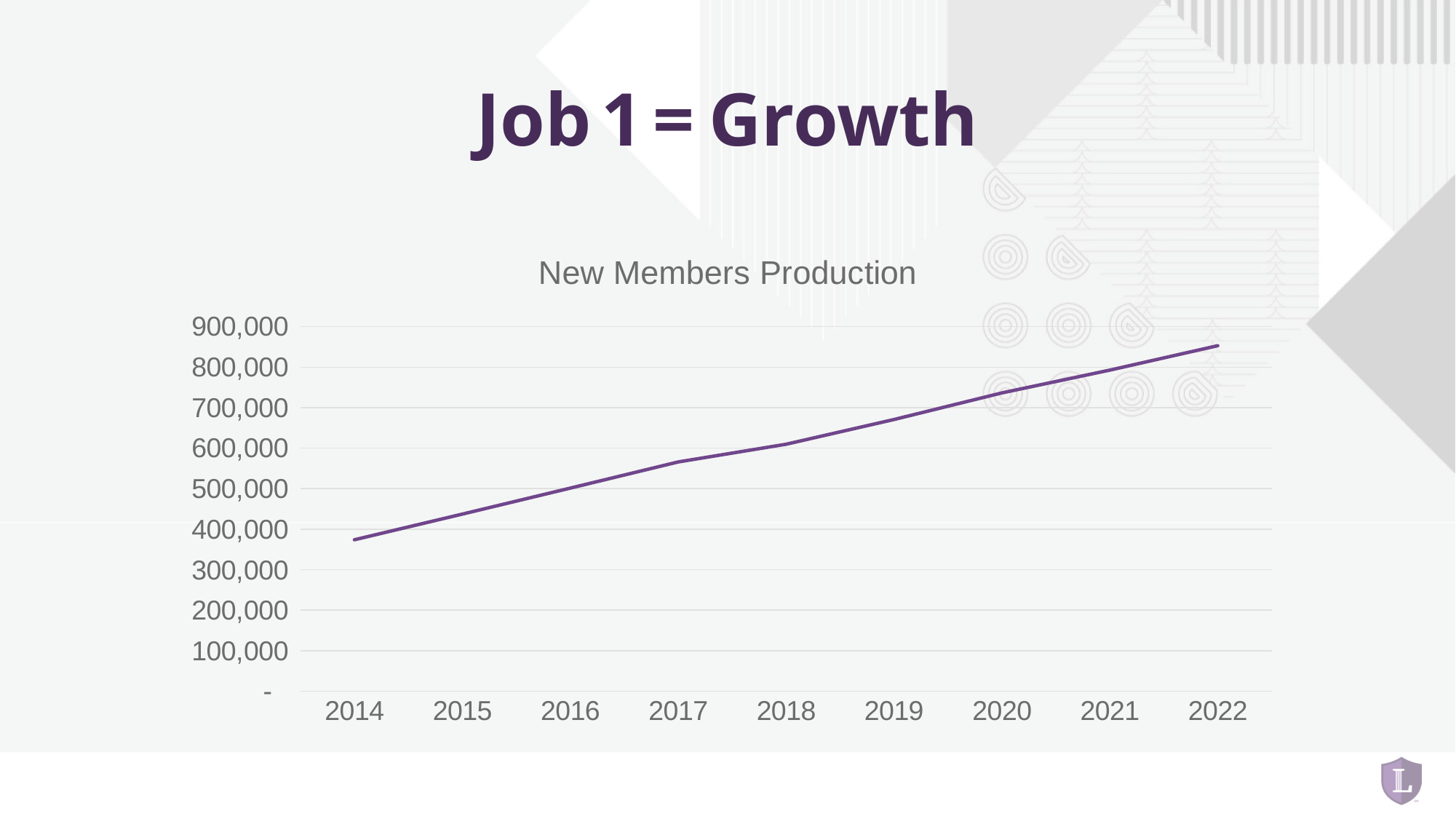
Which is larger, the value for 2020 or the value for 2016? 2020 How many years are plotted on the x axis? 9 Which year has the lowest value? 2014 What is the title of the chart? New Members Production Is the value for 2021 greater or less than 700,000? greater Is the value for 2022 greater or less than 800,000? greater Is the value for 2014 greater or less than 400,000? less Do the values rise or fall from 2014 to 2022? rise What kind of chart is shown on the slide? line chart Which year has the highest value? 2022